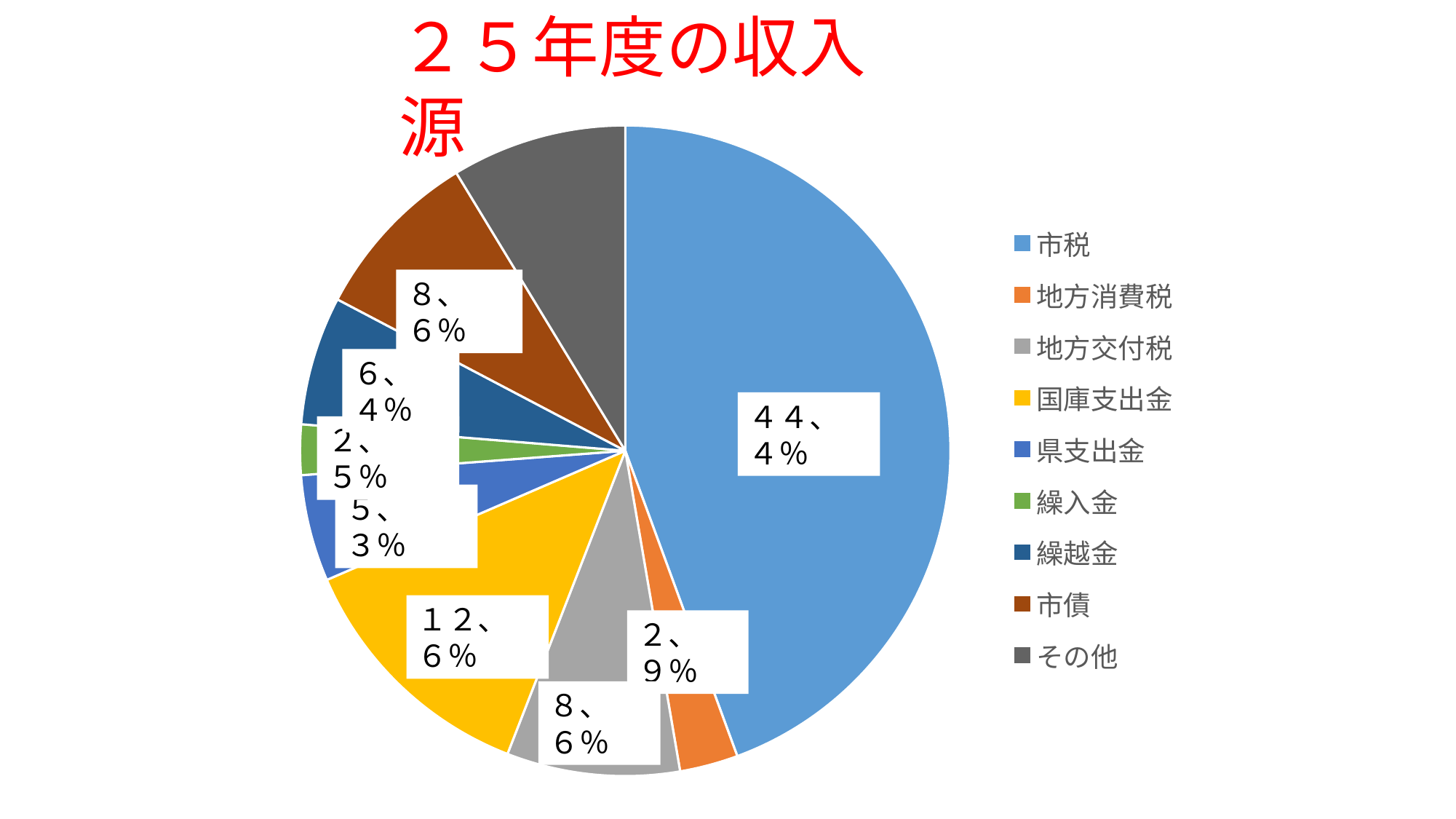
What is the value shown for 地方消費税? 2、9% What is the value shown for 国庫支出金? 12、6% What share of the pie does 市税 account for? 44、4% Which category has the smallest labelled slice of the pie? 繰入金 How many categories does the legend list? 9 What is the title of the chart? ２５年度の収入源 Which is larger, the slice for 国庫支出金 or the slice for 地方交付税? 国庫支出金 What kind of chart is shown on the slide? pie chart What is the difference in percentage points between 市税 and 国庫支出金? 31、8 What is the value shown for 県支出金? 5、3% Which category has the largest slice of the pie? 市税 What is the value shown for 繰越金? 6、4%